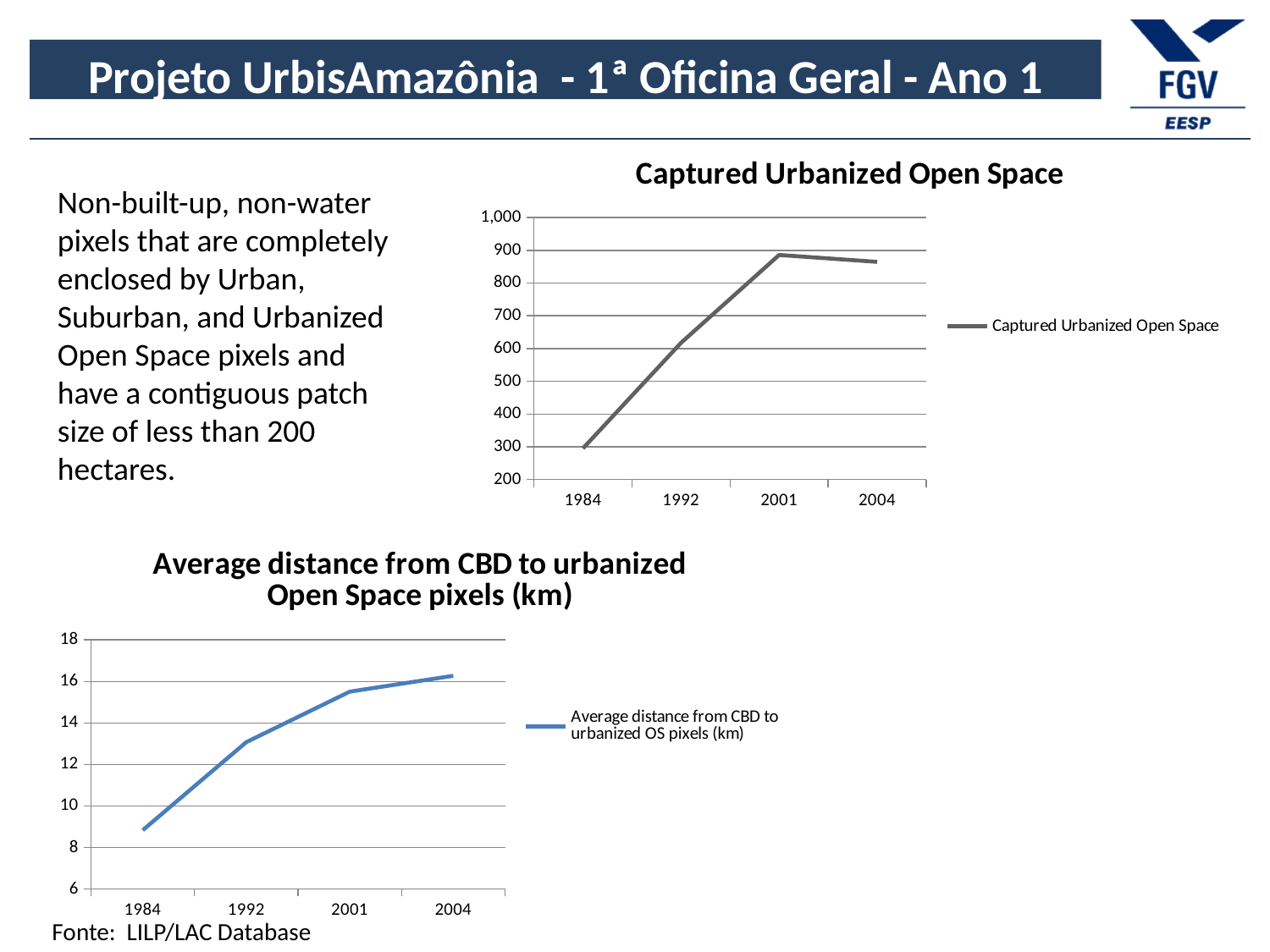
In the "Captured Urbanized Open Space" chart, is the value for 1992 greater or less than 500? greater In the "Average distance from CBD to urbanized Open Space pixels (km)" chart, does the value rise or fall from 1984 to 2004? rise How many years are plotted on the x axis of the "Captured Urbanized Open Space" chart? 4 In the "Average distance from CBD to urbanized Open Space pixels (km)" chart, which year has the highest value? 2004 In the "Average distance from CBD to urbanized Open Space pixels (km)" chart, is the value for 2001 greater or less than 14? greater In the "Captured Urbanized Open Space" chart, which year has the lowest value? 1984 In the "Average distance from CBD to urbanized Open Space pixels (km)" chart, is the value for 1984 greater or less than 10? less In the "Captured Urbanized Open Space" chart, which is larger, the value for 2001 or the value for 1992? 2001 What type of chart is the "Captured Urbanized Open Space" chart? line chart How many series does the legend of the "Average distance from CBD to urbanized Open Space pixels (km)" chart list? 1 In the "Captured Urbanized Open Space" chart, which year has the highest value? 2001